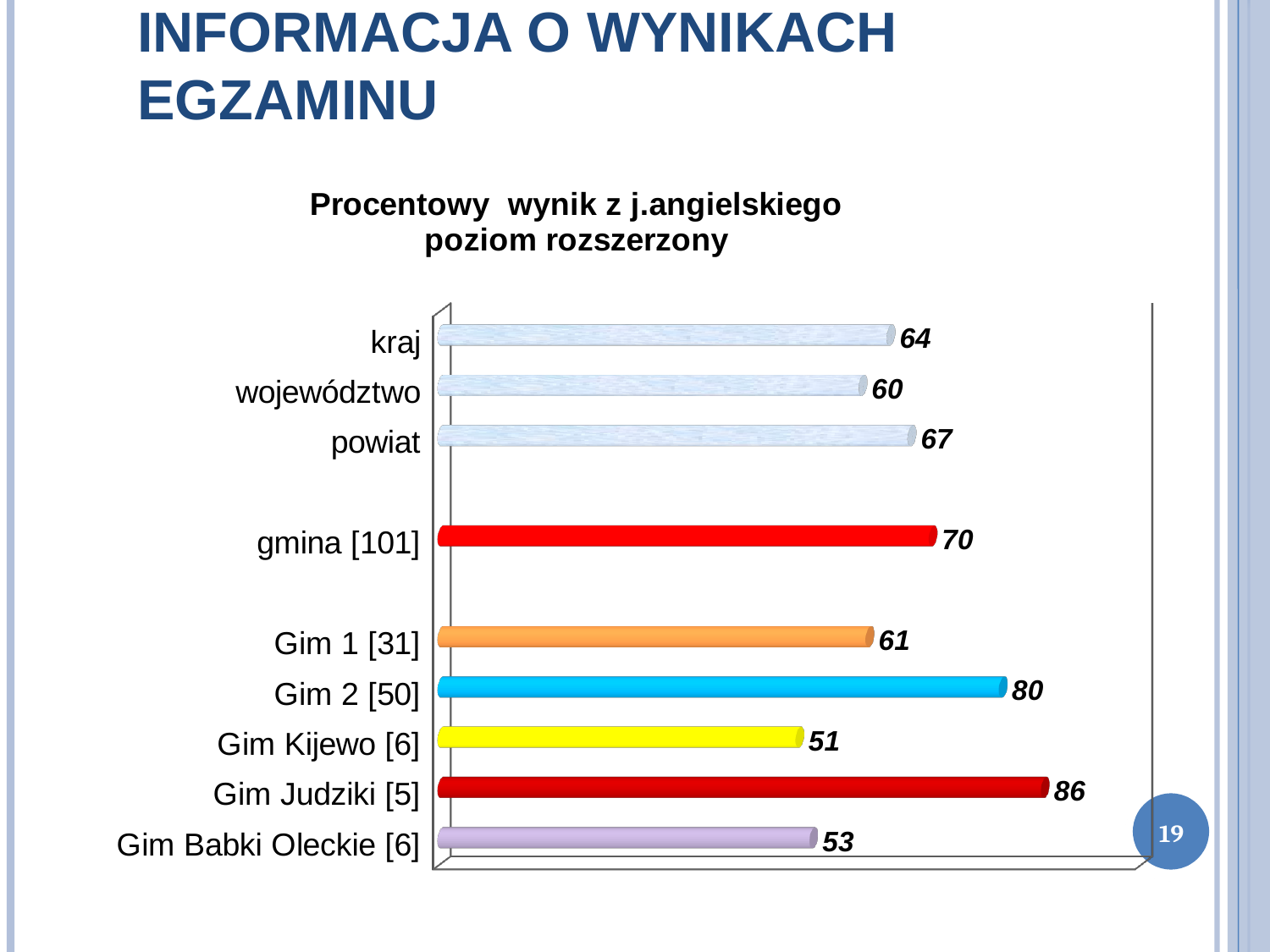
Which category has the highest value? Gim Judziki [5] Which is larger, the value for Gim 1 [31] or the value for Gim Babki Oleckie [6]? Gim 1 [31] What is the title of the chart? Procentowy wynik z j.angielskiego poziom rozszerzony What is the value for Gim 2 [50]? 80 Which category has the lowest value? Gim Kijewo [6] What kind of chart is shown on the slide? bar chart What is the difference between the values for Gim Judziki [5] and Gim Kijewo [6]? 35 What is the value for gmina [101]? 70 Which is larger, the value for gmina [101] or the value for kraj? gmina [101] What is the value for kraj? 64 What is the difference between the values for powiat and województwo? 7 How many categories are shown in the chart? 9